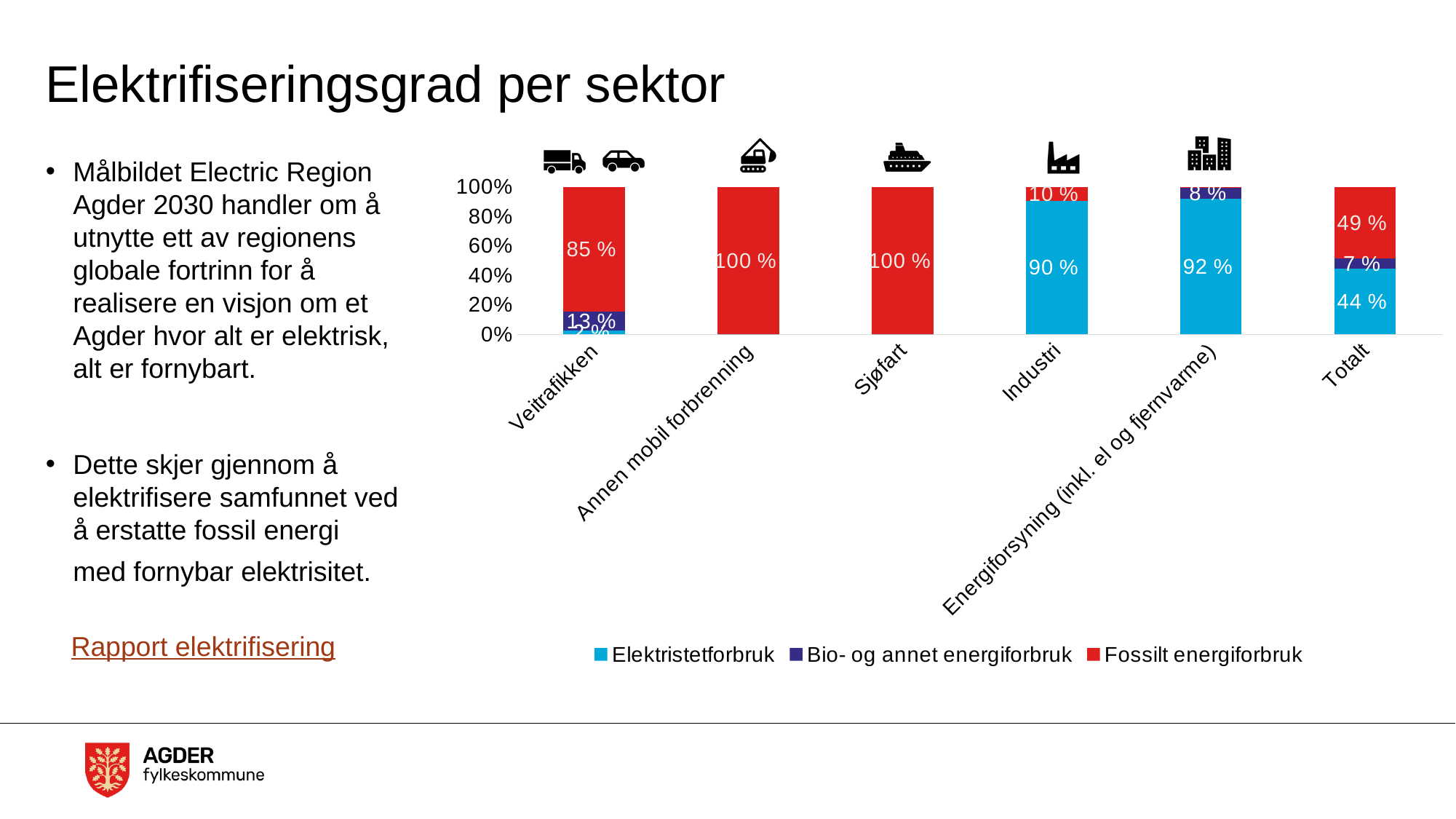
What is the share of Elektristetforbruk for Industri? 90 % How many series does the chart legend list? 3 What is the share of Bio- og annet energiforbruk for Energiforsyning (inkl. el og fjernvarme)? 8 % What is the share of Fossilt energiforbruk for Veitrafikken? 85 % Which sector has the highest share of Elektristetforbruk? Energiforsyning (inkl. el og fjernvarme) What kind of chart is shown on the slide? Stacked bar chart Which legend entry is shown in red? Fossilt energiforbruk How many sectors (categories) are shown on the x axis of the chart? 6 What is the difference between the Elektristetforbruk share for Energiforsyning (inkl. el og fjernvarme) and for Industri? 2 % What is the share of Elektristetforbruk for Totalt? 44 % Which is larger: the Fossilt energiforbruk share for Industri or for Veitrafikken? Veitrafikken What is the share of Fossilt energiforbruk for Totalt? 49 %